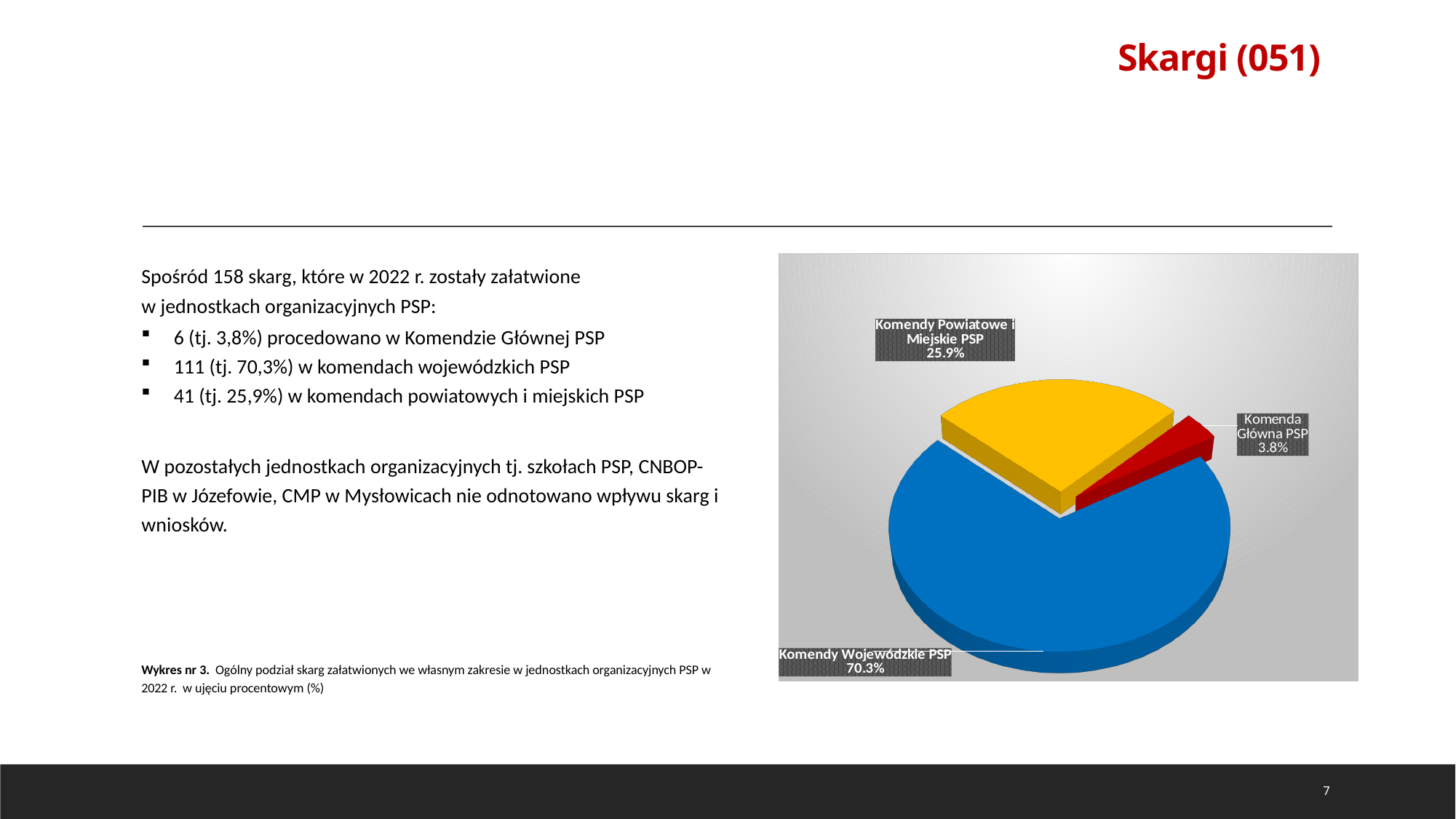
Which is larger: the share for Komendy Powiatowe i Miejskie PSP or the share for Komenda Główna PSP? Komendy Powiatowe i Miejskie PSP What share of the pie does Komendy Powiatowe i Miejskie PSP have? 25.9% What is the difference in percentage points between Komendy Powiatowe i Miejskie PSP and Komenda Główna PSP? 22.1 What share of the pie does Komenda Główna PSP have? 3.8% Which category has the largest slice of the pie? Komendy Wojewódzkie PSP What kind of chart is shown on the slide? pie chart What colour is the slice for Komenda Główna PSP? red How many slices does the pie chart have? 3 What share of the pie does Komendy Wojewódzkie PSP have? 70.3% What colour is the slice for Komendy Wojewódzkie PSP? blue What is the difference in percentage points between Komendy Wojewódzkie PSP and Komendy Powiatowe i Miejskie PSP? 44.4 Which category has the smallest slice of the pie? Komenda Główna PSP